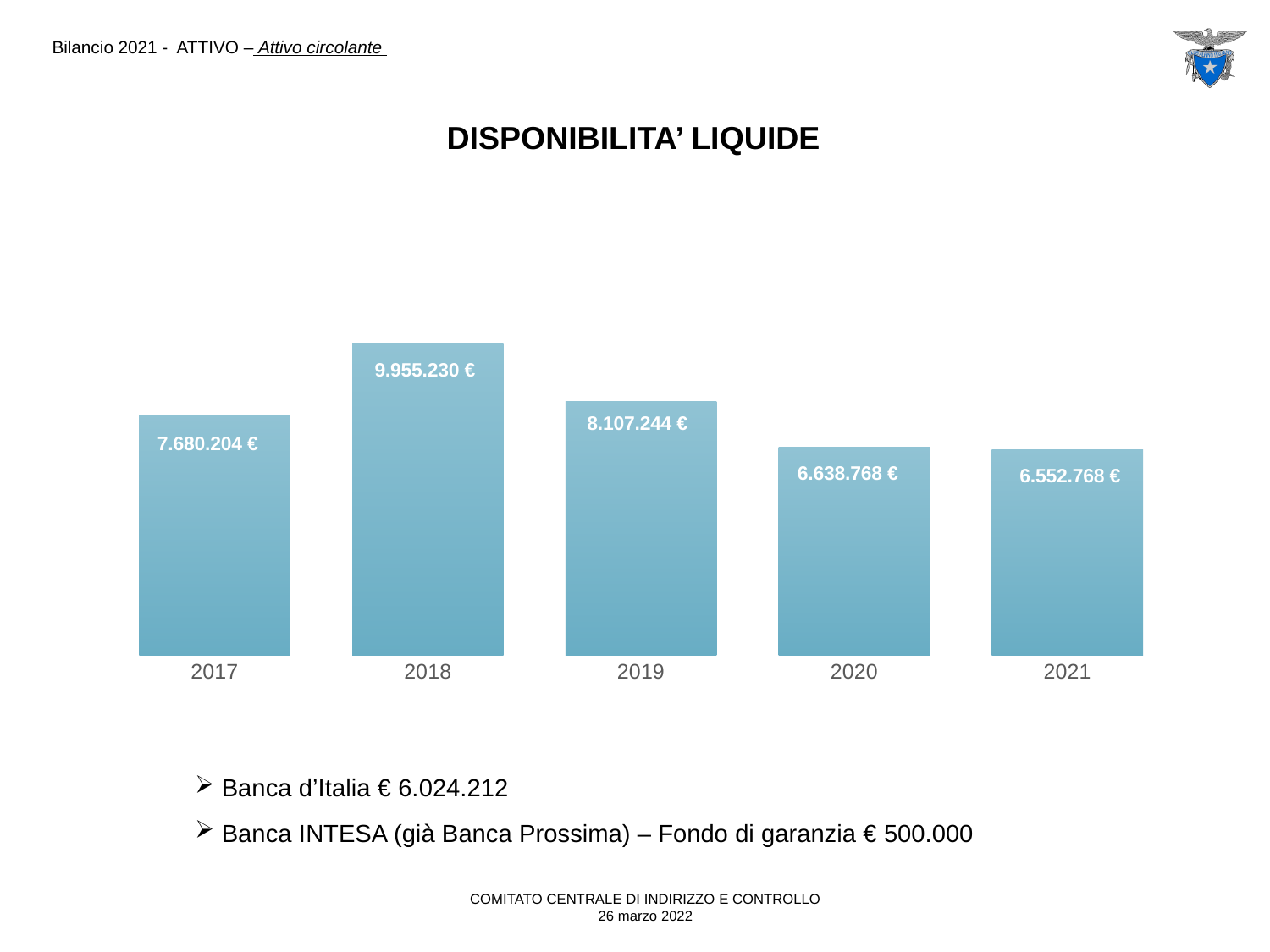
Which is larger, the value for 2017 or the value for 2019? 2019 What is the value shown for 2018? 9.955.230 € Do the values rise or fall from 2018 to 2021? Fall What is the value shown for 2021? 6.552.768 € How many years are shown on the x axis? 5 What kind of chart is shown on the slide? Bar chart What is the difference between the values for 2018 and 2017? 2.275.026 € Which year has the highest value? 2018 Which year has the lowest value? 2021 What is the value shown for 2019? 8.107.244 € What is the title of the chart? DISPONIBILITA' LIQUIDE What is the difference between the values for 2020 and 2021? 86.000 €